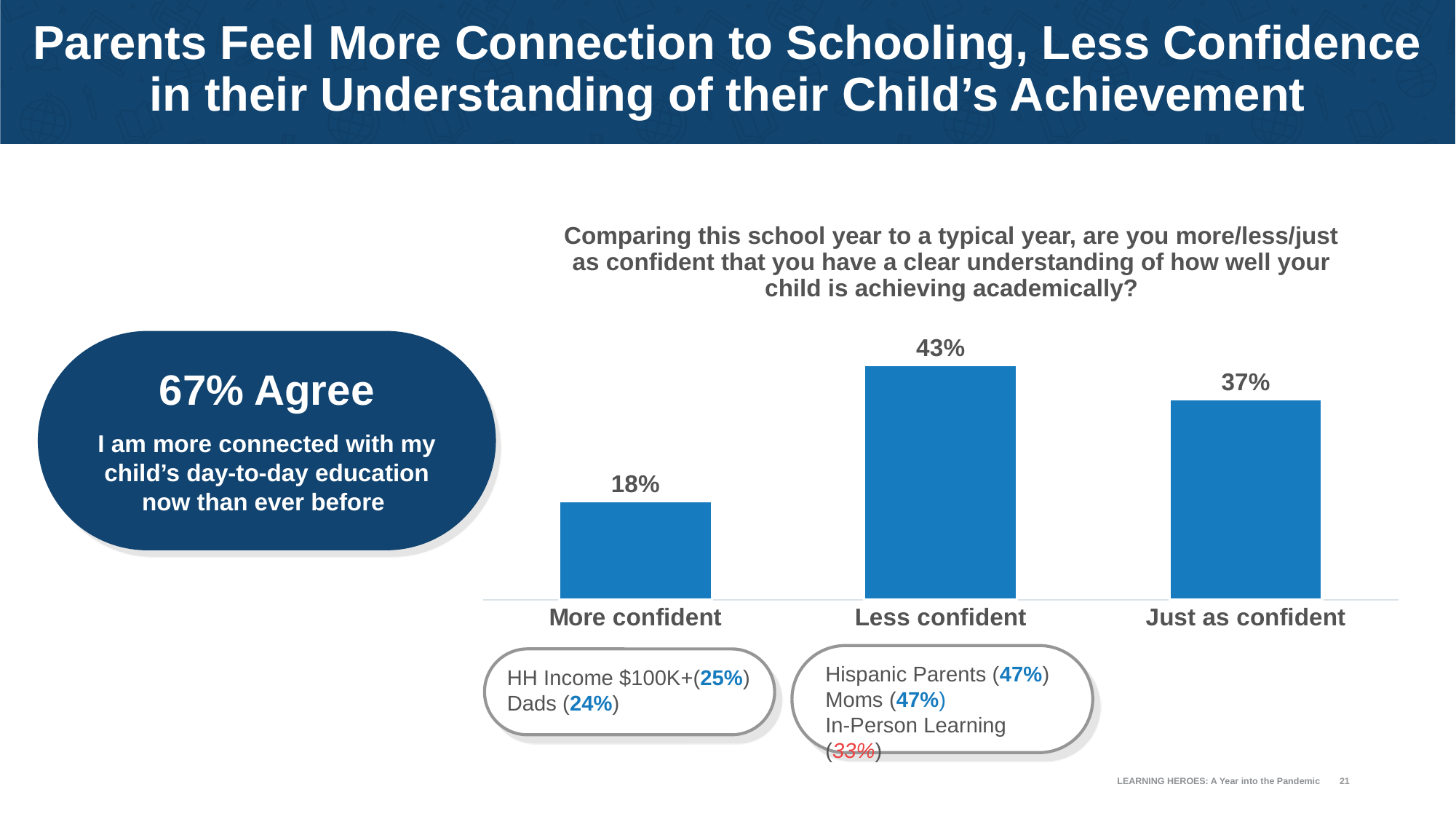
Which response category has the highest value? Less confident What is the total of the three percentages shown in the chart? 98% What percentage of parents said they are less confident? 43% Which is larger, the value for 'Just as confident' or the value for 'More confident'? Just as confident What kind of chart is shown on the slide? Bar chart How many response categories are shown in the chart? 3 What percentage of parents said they are just as confident? 37% What percentage of parents agree that they are more connected with their child's day-to-day education now than ever before? 67% What is the difference between the 'Less confident' and 'Just as confident' values? 6% What is the difference between the 'Less confident' and 'More confident' values? 25% What percentage of parents said they are more confident? 18% Which response category has the lowest value? More confident